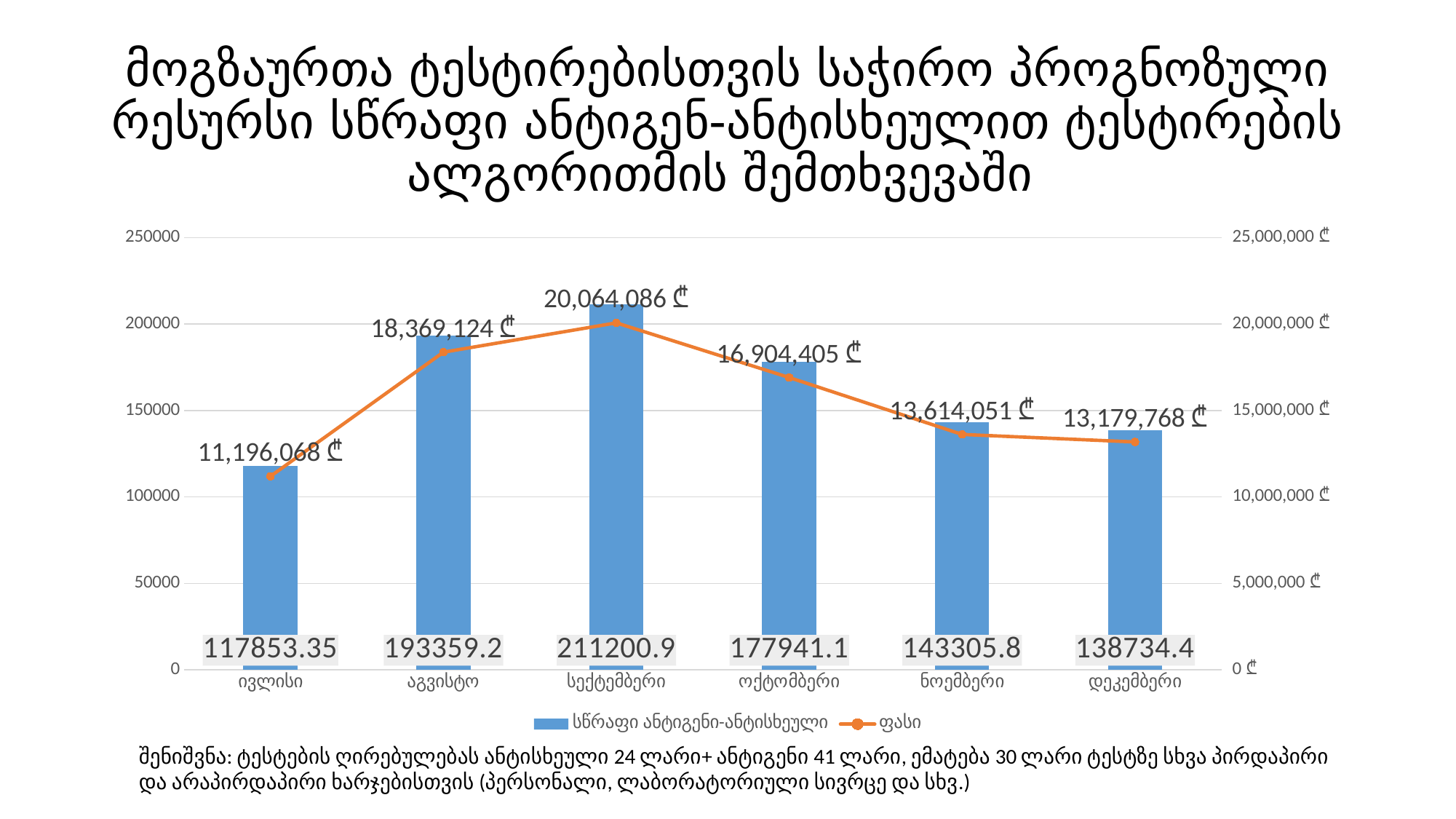
How many months are shown on the x axis? 6 What kind of chart is shown on the slide? Combined bar and line chart Does the ფასი line rise or fall from სექტემბერი to დეკემბერი? Falls What is the ფასი value shown for ივლისი? 11,196,068 ₾ Which month has the lowest ფასი value? ივლისი What is the ფასი value shown for ნოემბერი? 13,614,051 ₾ Is the სწრაფი ანტიგენი-ანტისხეული bar for ოქტომბერი greater or less than 150000? greater How many series does the legend list? 2 Which month has the highest სწრაფი ანტიგენი-ანტისხეული bar? სექტემბერი Which is larger, the სწრაფი ანტიგენი-ანტისხეული bar for ნოემბერი or for დეკემბერი? ნოემბერი What is the value of the სწრაფი ანტიგენი-ანტისხეული bar for სექტემბერი? 211200.9 What is the difference between the ფასი values for სექტემბერი and აგვისტო? 1,694,962 ₾